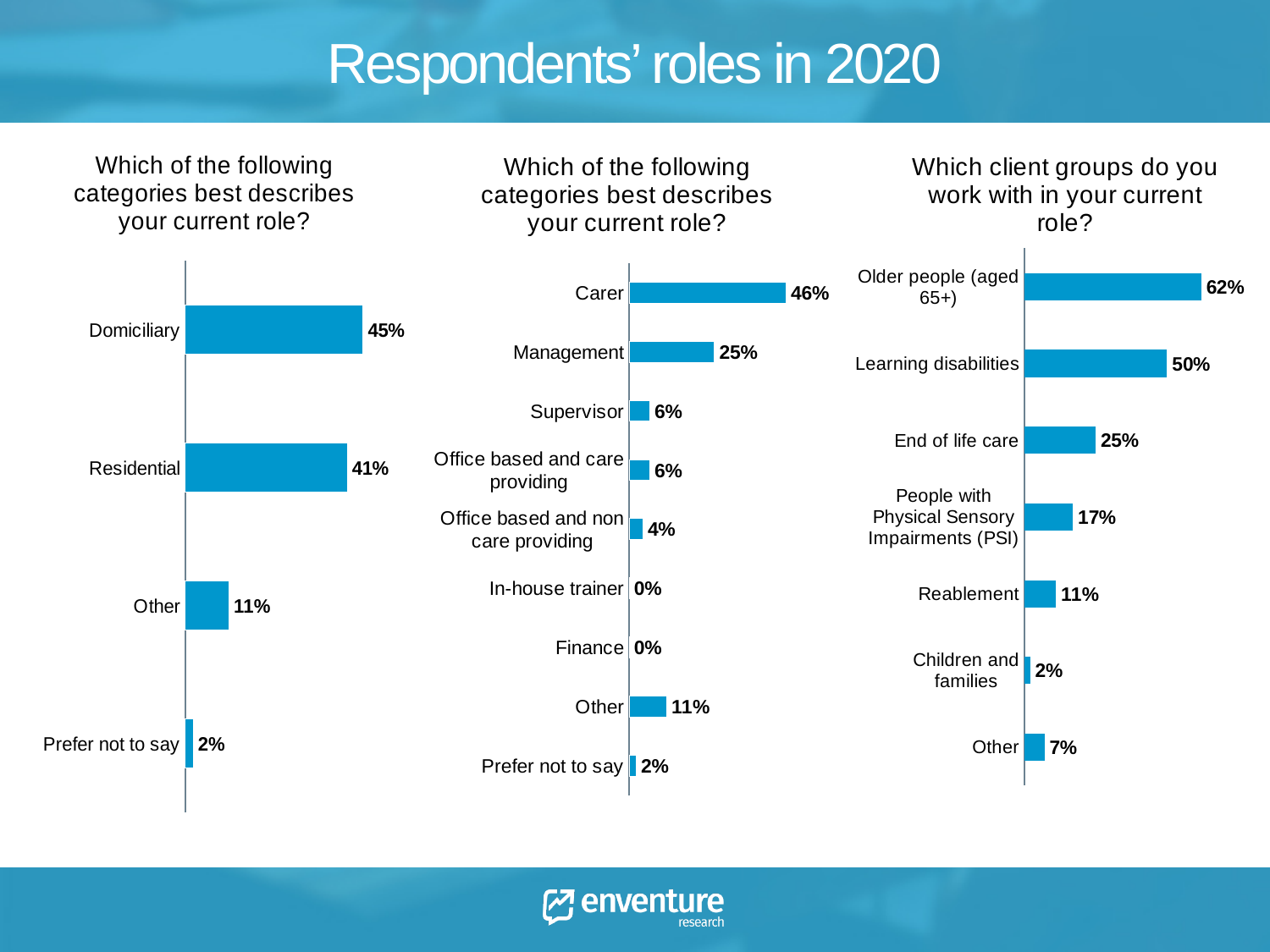
In the left chart, what percentage of respondents selected Domiciliary? 45% In the left chart, what is the difference between Domiciliary and Residential? 4% In the chart titled 'Which client groups do you work with in your current role?', which client group has the highest value? Older people (aged 65+) In the middle chart, which is larger, Management or Other? Management In the chart titled 'Which client groups do you work with in your current role?', what is the value for Learning disabilities? 50% In the middle chart, what percentage of respondents selected Carer? 46% In the chart titled 'Which client groups do you work with in your current role?', what is the difference between End of life care and Reablement? 14% In the left chart, which category has the lowest value? Prefer not to say What type of chart is used on the right of the slide? Bar chart In the middle chart, what is the value for Office based and non care providing? 4% In the middle chart, how many categories are shown? 9 In the middle chart, which category has the highest value? Carer